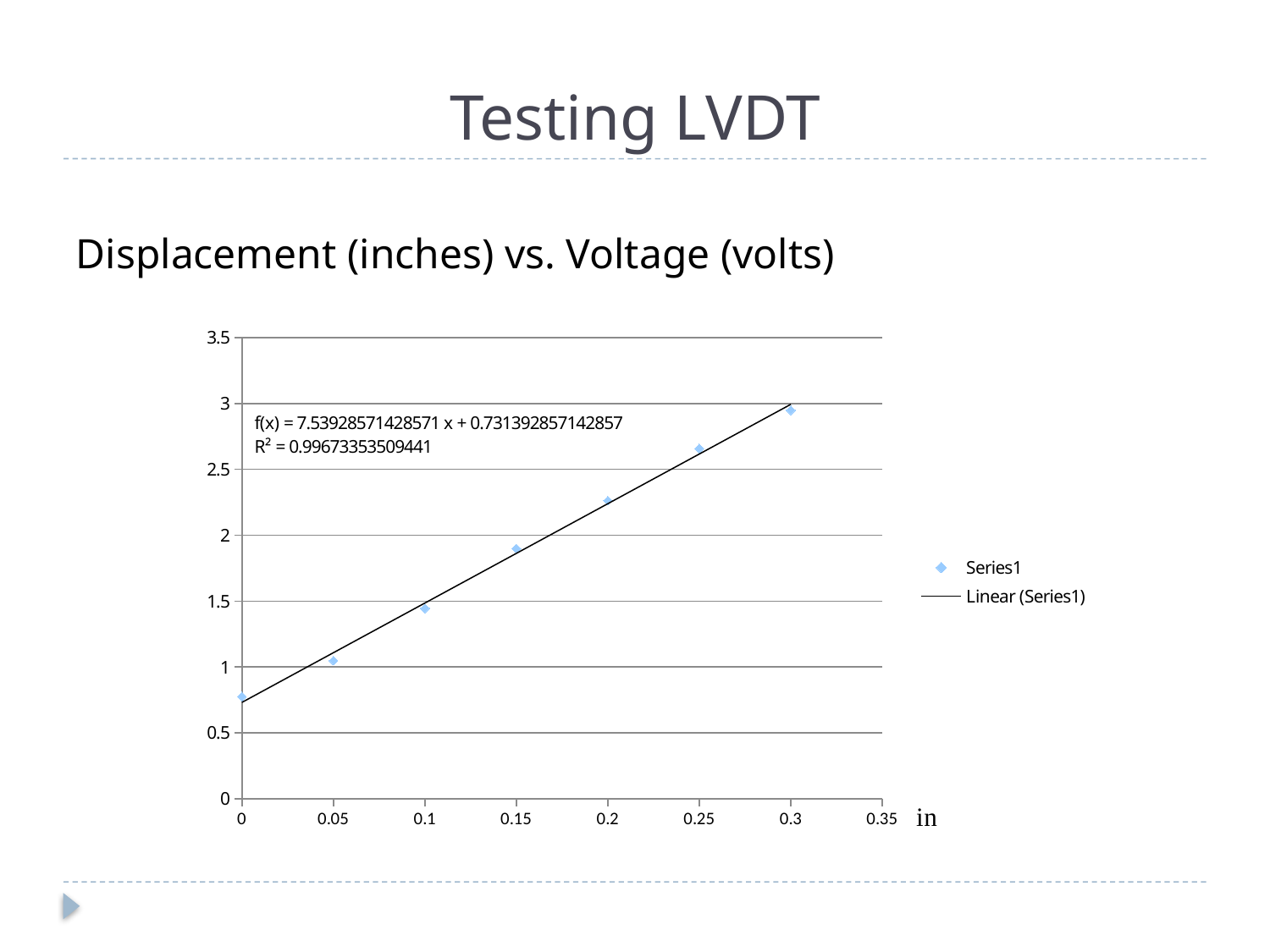
How many entries does the chart legend list? 2 How many data points are plotted in the chart? 7 At which x value is the plotted voltage highest? 0.3 Which has the larger plotted value, x = 0.2 or x = 0.1? 0.2 Is the value at x = 0.3 greater or less than 2.5? greater Do the plotted values rise or fall as displacement increases along the x axis? rise Is the value at x = 0.2 greater or less than 2? greater At which x value is the plotted voltage lowest? 0 What kind of chart is shown on the slide? scatter chart What is the name of the second legend entry in the chart? Linear (Series1) Is the value at x = 0 greater or less than 1? less What R² value is printed on the chart for the linear fit? 0.99673353509441